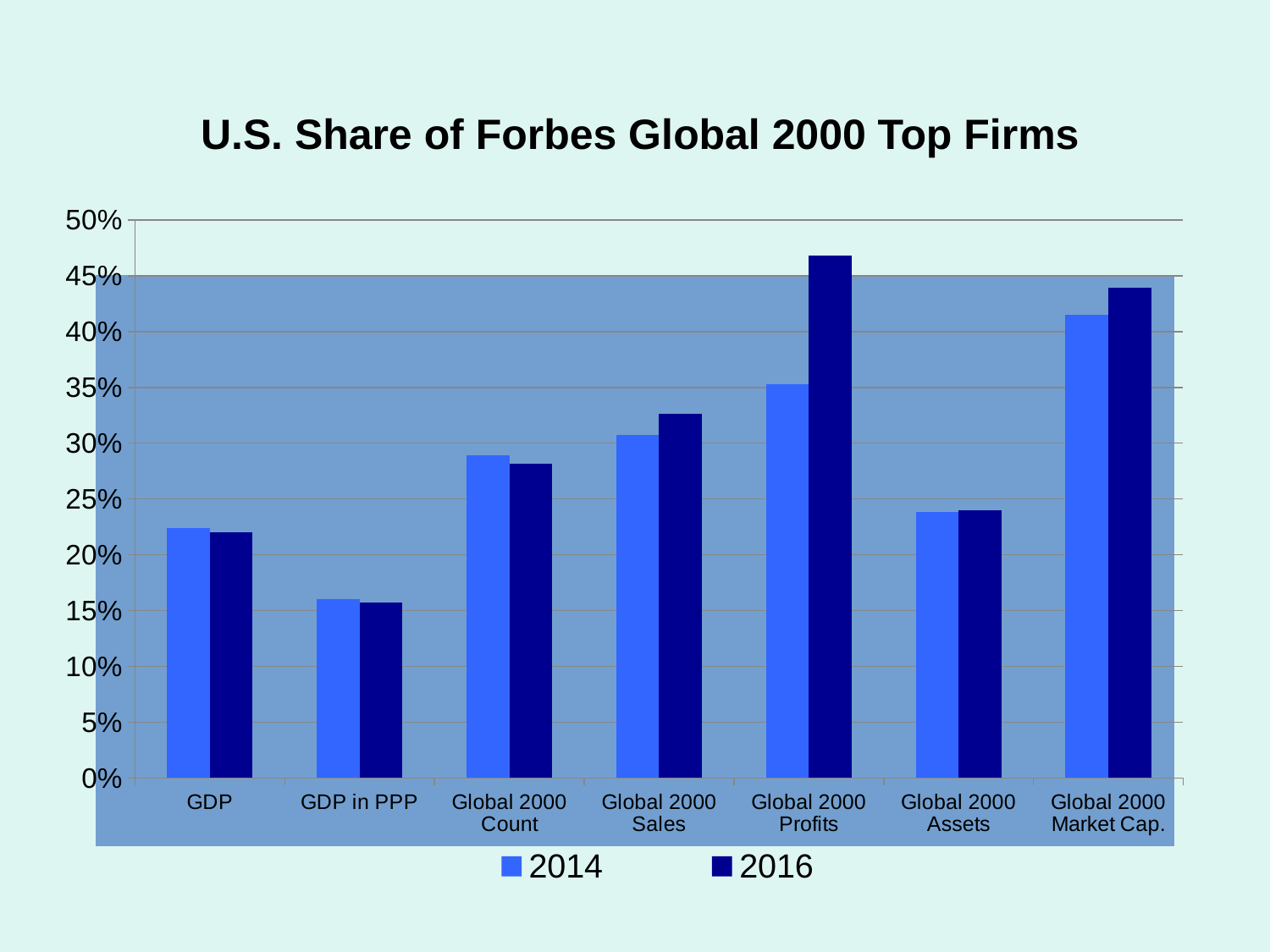
For Global 2000 Sales, which year has the larger value, 2014 or 2016? 2016 How many series does the legend list? 2 What kind of chart is shown on the slide? bar chart Which category has the highest value for 2016? Global 2000 Profits Which category has the highest value for 2014? Global 2000 Market Cap. Is the 2016 value for Global 2000 Profits greater or less than 45%? greater How many categories are shown on the x axis? 7 Which category has the lowest value for 2016? GDP in PPP What is the title of the chart? U.S. Share of Forbes Global 2000 Top Firms Is the 2016 value for Global 2000 Assets greater or less than 25%? less Is the 2014 value for Global 2000 Market Cap. greater or less than 40%? greater For Global 2000 Profits, which year has the larger value, 2014 or 2016? 2016